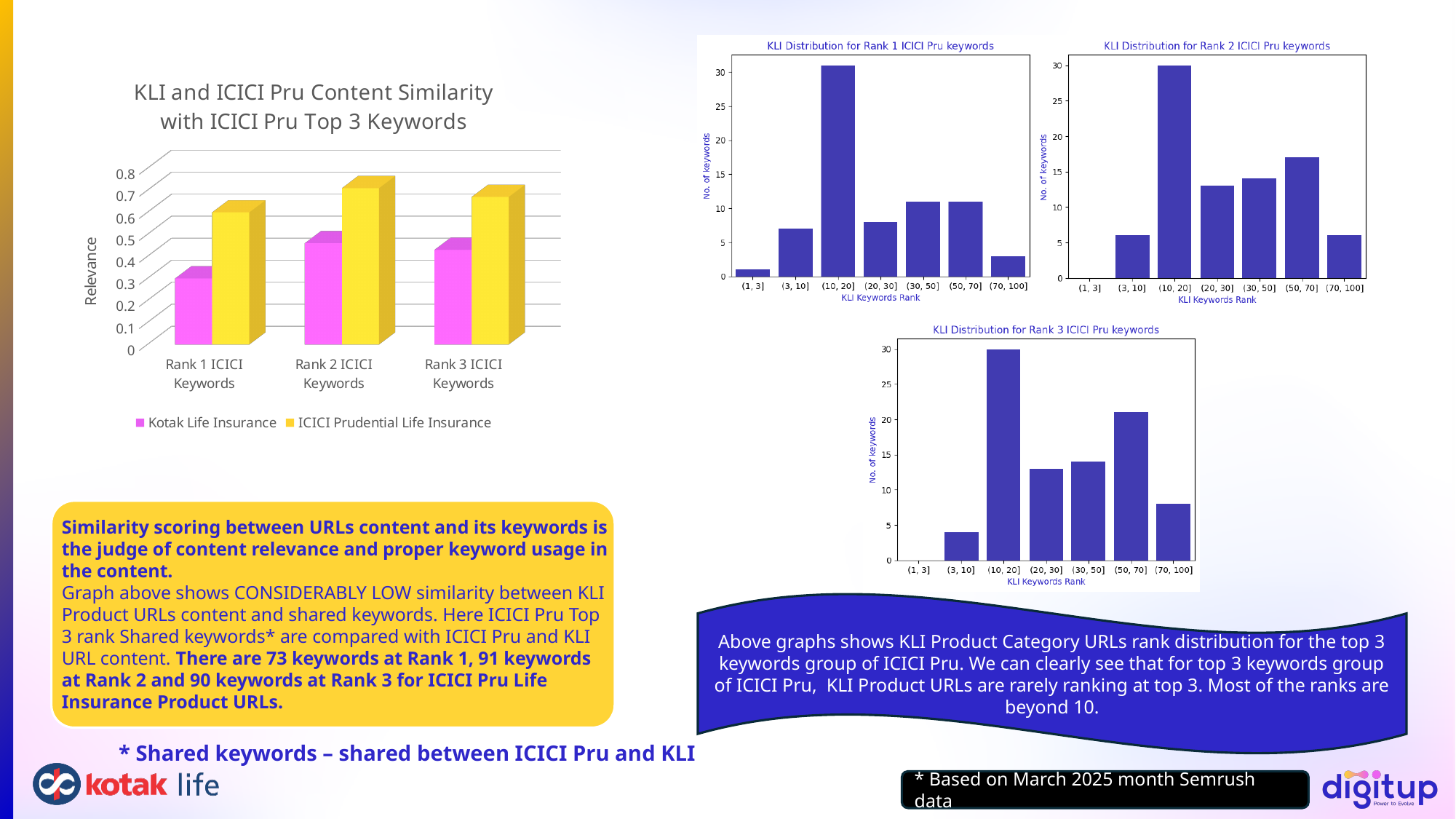
In the 'KLI and ICICI Pru Content Similarity' chart, which category has the lowest Kotak Life Insurance value? Rank 1 ICICI Keywords What is the y-axis label of the 'KLI Distribution for Rank 3 ICICI Pru keywords' chart? No. of keywords In the 'KLI and ICICI Pru Content Similarity' chart, is the ICICI Prudential Life Insurance value for Rank 2 ICICI Keywords greater or less than 0.6? greater In the 'KLI Distribution for Rank 1 ICICI Pru keywords' chart, which KLI Keywords Rank bin has the most keywords? (10, 20] In the 'KLI Distribution for Rank 2 ICICI Pru keywords' chart, which bin has more keywords, (50, 70] or (70, 100]? (50, 70] In the 'KLI Distribution for Rank 1 ICICI Pru keywords' chart, which KLI Keywords Rank bin has the fewest keywords? (1, 3] In the 'KLI and ICICI Pru Content Similarity' chart, is the Kotak Life Insurance value for Rank 1 ICICI Keywords greater or less than 0.5? less How many KLI Keywords Rank bins are shown on the x axis of the 'KLI Distribution for Rank 2 ICICI Pru keywords' chart? 7 How many series does the legend of the 'KLI and ICICI Pru Content Similarity' chart list? 2 What kind of chart is the 'KLI and ICICI Pru Content Similarity with ICICI Pru Top 3 Keywords' chart? Bar chart In the 'KLI and ICICI Pru Content Similarity' chart, which series has the higher value for Rank 2 ICICI Keywords, Kotak Life Insurance or ICICI Prudential Life Insurance? ICICI Prudential Life Insurance